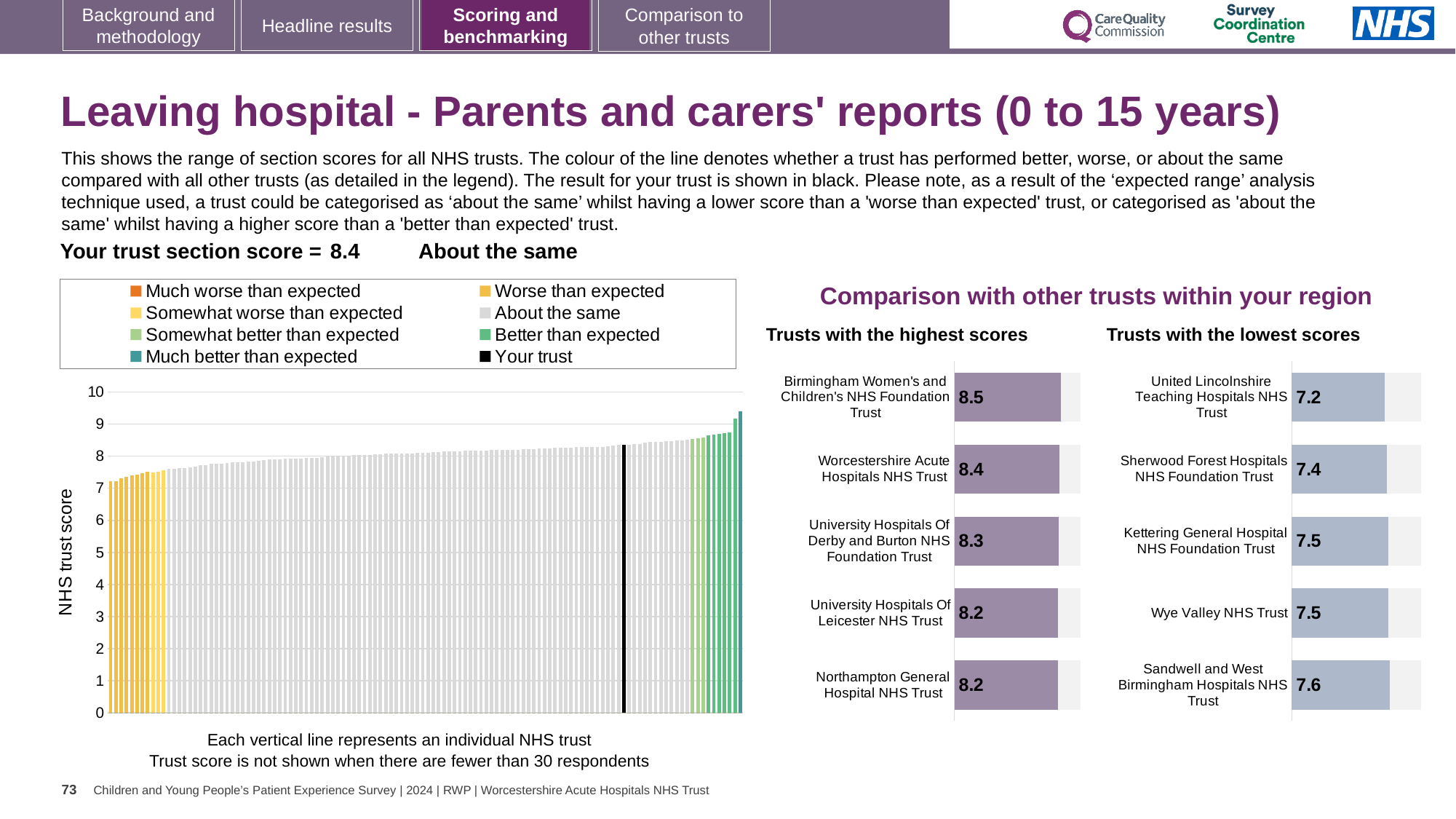
In the 'Trusts with the lowest scores' chart, what is the score for United Lincolnshire Teaching Hospitals NHS Trust? 7.2 In the 'Trusts with the highest scores' chart, what is the score for Worcestershire Acute Hospitals NHS Trust? 8.4 In the NHS trust score chart on the left, do the bar values rise or fall from left to right along the x axis? Rise In the 'Trusts with the lowest scores' chart, which has the higher score: Sherwood Forest Hospitals NHS Foundation Trust or Sandwell and West Birmingham Hospitals NHS Trust? Sandwell and West Birmingham Hospitals NHS Trust In the NHS trust score chart on the left, what is the section score for your trust (the black bar)? 8.4 In the 'Trusts with the lowest scores' chart, which trust has the lowest score? United Lincolnshire Teaching Hospitals NHS Trust In the 'Trusts with the highest scores' chart, what is the score for Birmingham Women's and Children's NHS Foundation Trust? 8.5 In the 'Trusts with the highest scores' chart, which trust has the highest score? Birmingham Women's and Children's NHS Foundation Trust In the 'Trusts with the highest scores' chart, what is the difference between the scores of Birmingham Women's and Children's NHS Foundation Trust and Northampton General Hospital NHS Trust? 0.3 How many entries does the legend of the NHS trust score chart on the left list? 8 How many trusts are shown in the 'Trusts with the lowest scores' chart? 5 What kind of chart is the NHS trust score chart on the left? Bar chart